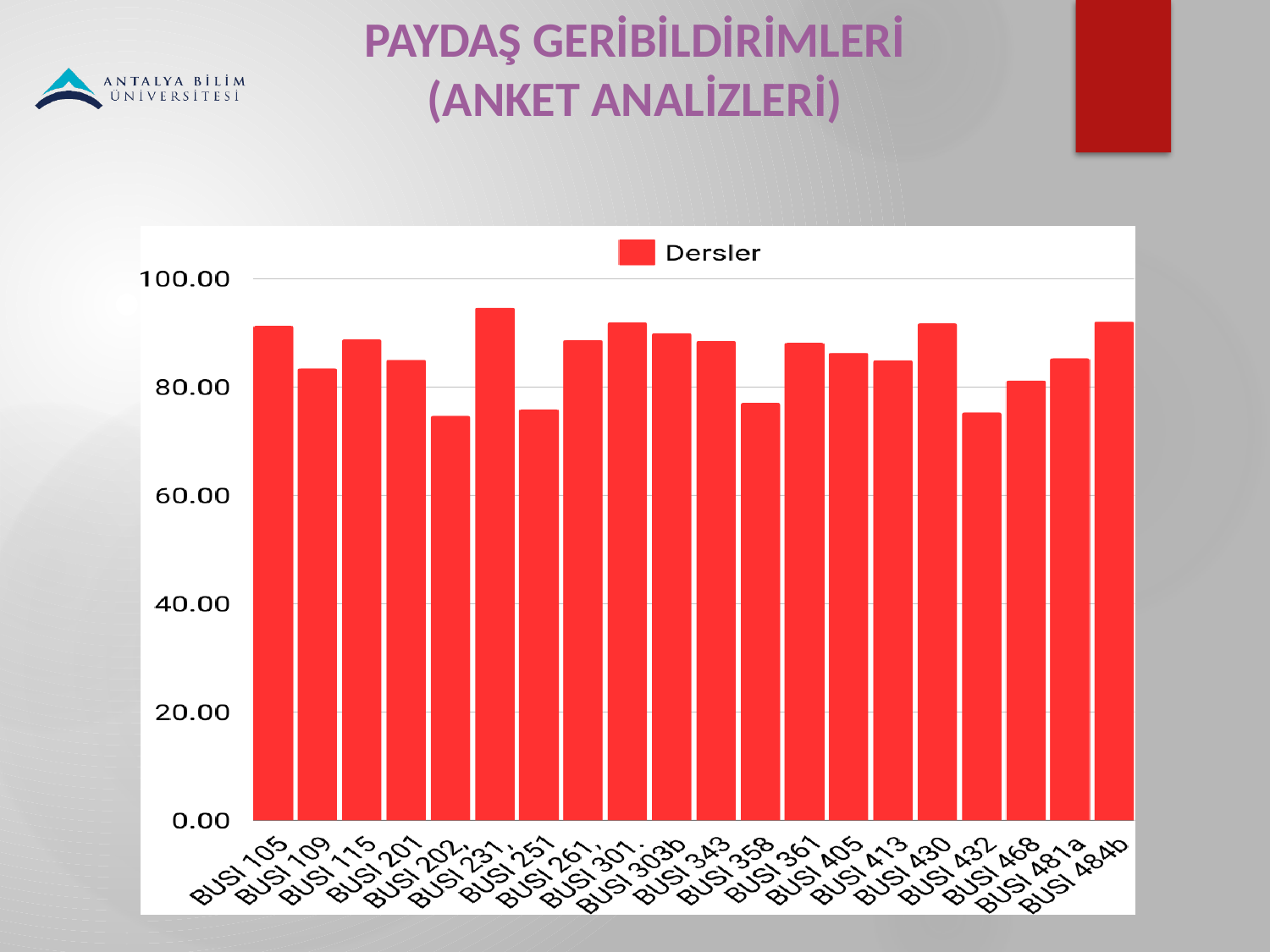
How many courses (categories) are plotted on the x axis? 20 Is the value for BUSI 202 greater or less than 80? less What kind of chart is shown on the slide? bar chart How many series does the legend list? 1 Is the value for BUSI 231 greater or less than 80? greater Which has the larger value, BUSI 105 or BUSI 109? BUSI 105 Is the value for BUSI 358 greater or less than 80? less What colour are the bars in the chart? red Which course has the highest bar? BUSI 231 Which has the larger value, BUSI 231 or BUSI 202? BUSI 231 What is the name of the series shown in the legend? Dersler